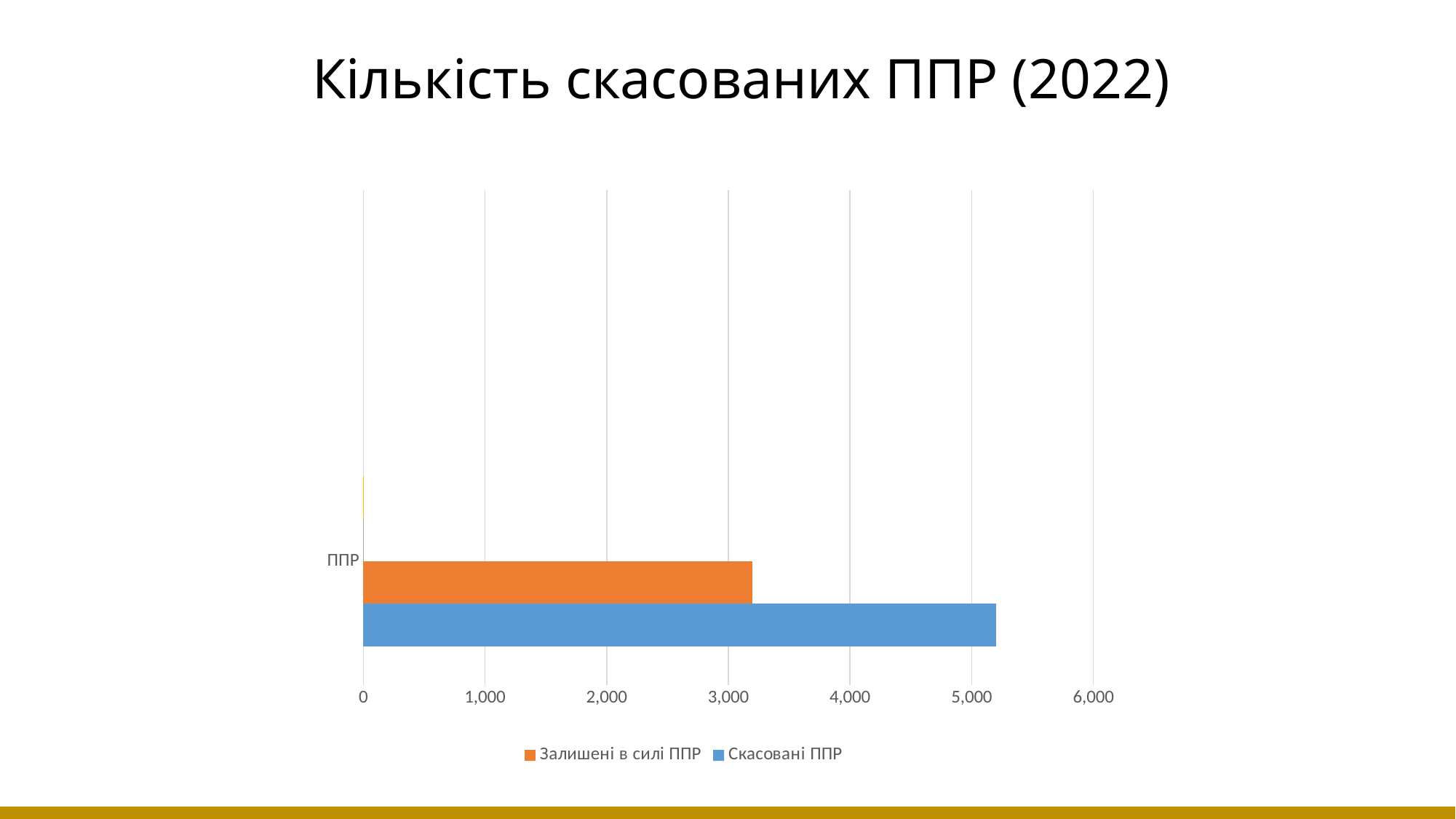
Is the value for Залишені в силі ППР greater or less than 4,000? less Which series has the larger value: Залишені в силі ППР or Скасовані ППР? Скасовані ППР How many categories are shown on the vertical axis? 1 Is the value for Скасовані ППР greater or less than 5,000? greater Which series has the highest value? Скасовані ППР Is the value for Залишені в силі ППР greater or less than 3,000? greater What is the title of the chart? Кількість скасованих ППР (2022) Which series has the lowest value? Залишені в силі ППР What kind of chart is shown on the slide? bar chart Which colour represents the series Скасовані ППР? blue How many series does the legend list? 2